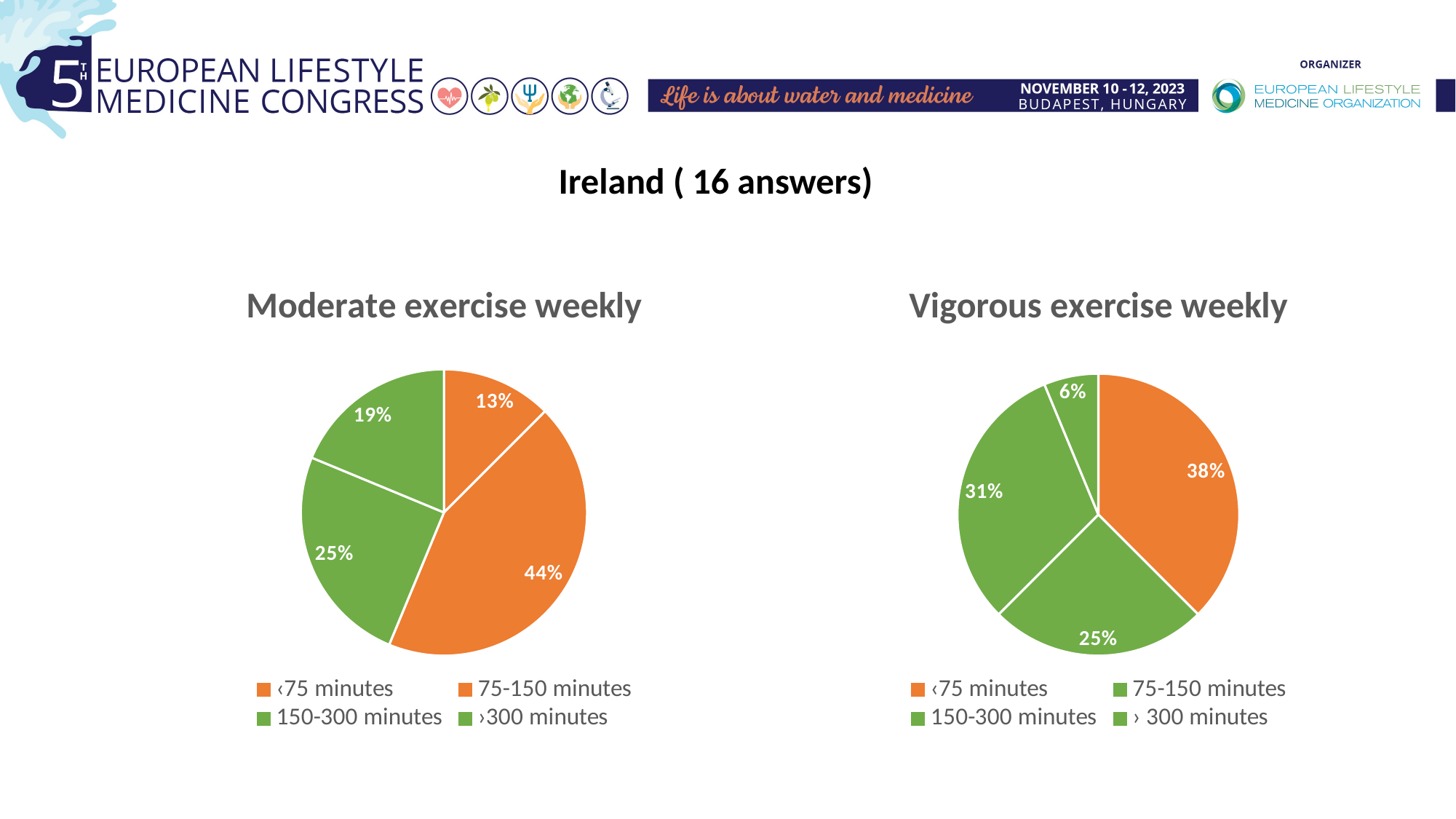
In the Moderate exercise weekly chart, which category has the smallest slice? ‹75 minutes In the Moderate exercise weekly chart, what percentage is shown for the 75-150 minutes slice? 44% How many answers does the slide title say the Ireland data is based on? 16 In the Moderate exercise weekly chart, what share of the pie does the 150-300 minutes slice represent? 25% In the Moderate exercise weekly chart, which is larger: the 150-300 minutes slice or the ›300 minutes slice? 150-300 minutes In the Vigorous exercise weekly chart, which category has the smallest slice? › 300 minutes In the Vigorous exercise weekly chart, what is the difference in percentage points between the ‹75 minutes slice and the 150-300 minutes slice? 7 In the Vigorous exercise weekly chart, what percentage is shown for the › 300 minutes slice? 6% In the Moderate exercise weekly chart, which category has the largest slice? 75-150 minutes How many slices does the Vigorous exercise weekly pie chart have? 4 What type of chart is the Moderate exercise weekly chart? Pie chart In the Vigorous exercise weekly chart, what percentage is shown for the ‹75 minutes slice? 38%